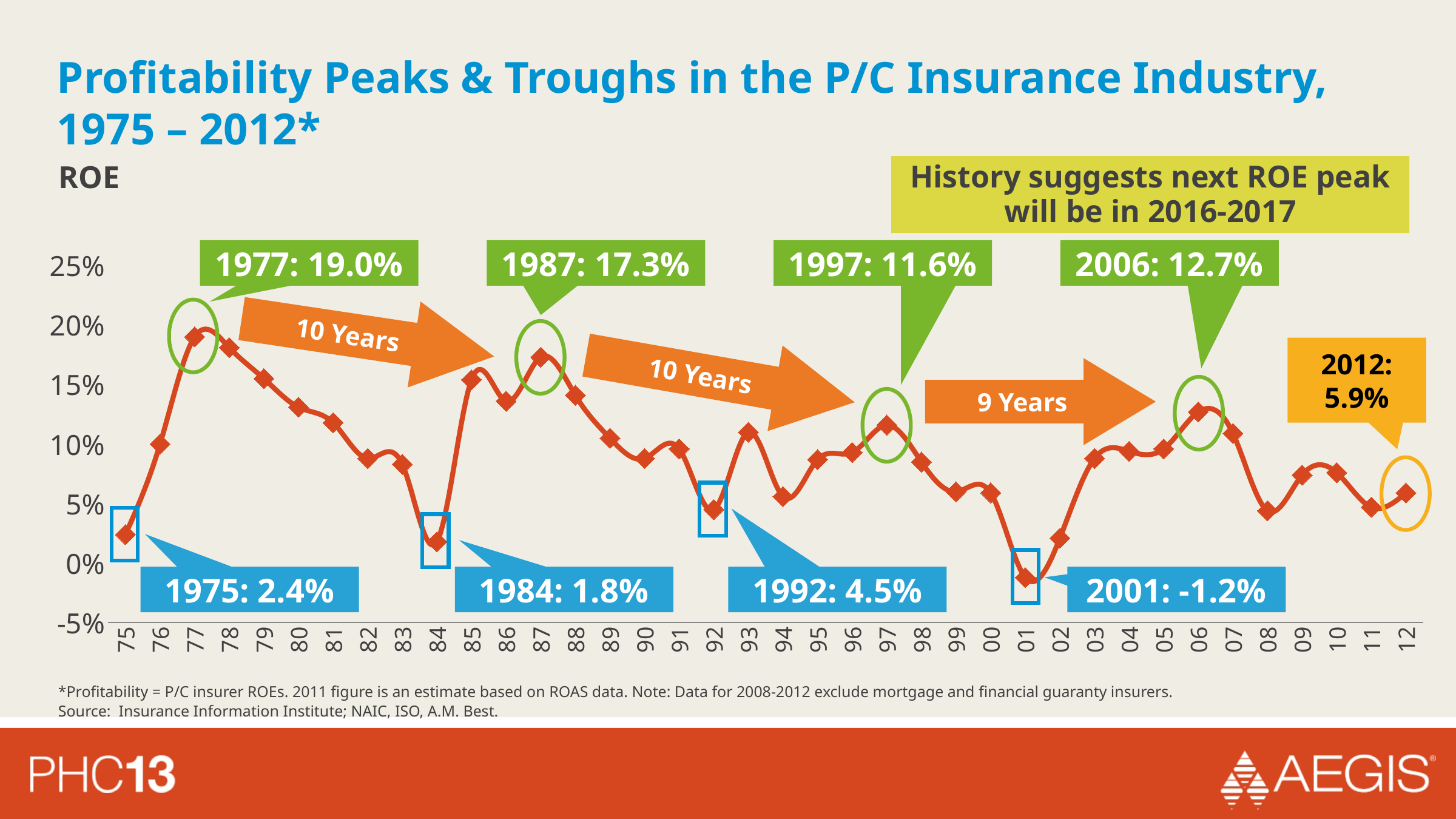
Is the ROE value for 2008 greater or less than 5%? less Which year has the highest ROE on the chart? 1977 What kind of chart is shown on the slide? Line chart Which was larger, the ROE in 1997 or the ROE in 2006? 2006 What was the ROE in 2012? 5.9% Is the ROE value for 1980 greater or less than 10%? greater What was the ROE in 1977? 19.0% What is the difference between the 2006 ROE and the 2012 ROE? 6.8 percentage points Which year has the lowest ROE on the chart? 2001 How many years are plotted on the x axis? 38 How much higher was the 1977 ROE peak than the 1987 peak? 1.7 percentage points What ROE value is labeled for 2001? -1.2%